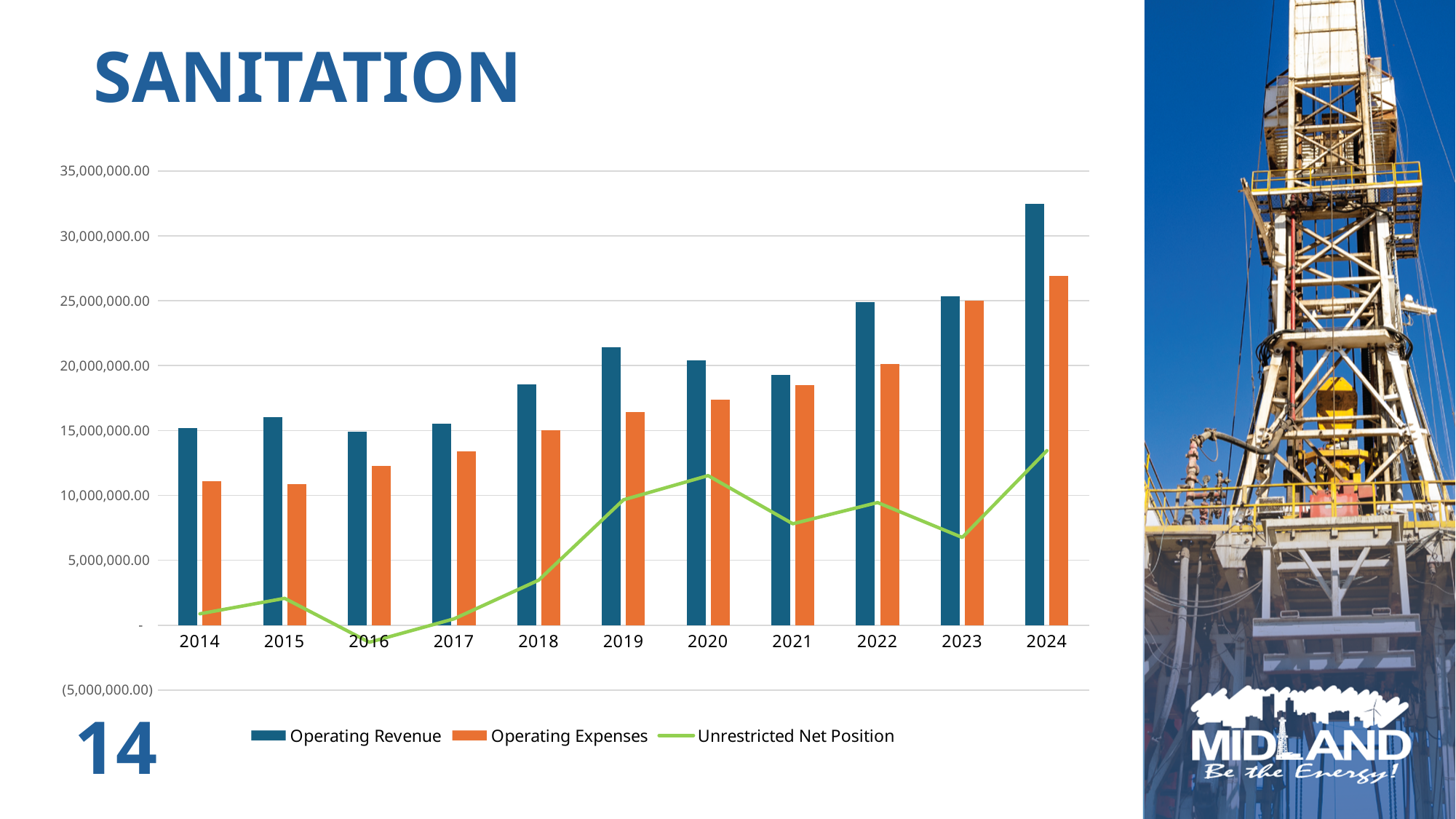
Is the Operating Expenses value for 2014 greater or less than 15,000,000.00? less In 2019, which is larger: Operating Revenue or Operating Expenses? Operating Revenue In which year is the Unrestricted Net Position highest? 2024 In which year is Operating Expenses highest? 2024 In which year is Operating Revenue highest? 2024 How many years are shown on the x axis? 11 Is the Unrestricted Net Position for 2020 greater or less than 10,000,000.00? greater What kind of chart is shown on the slide? bar chart with a line Is the Operating Revenue for 2024 greater or less than 30,000,000.00? greater In which year is the Unrestricted Net Position lowest? 2016 How many series does the legend list? 3 Do Operating Expenses generally rise or fall from 2016 to 2024? rise